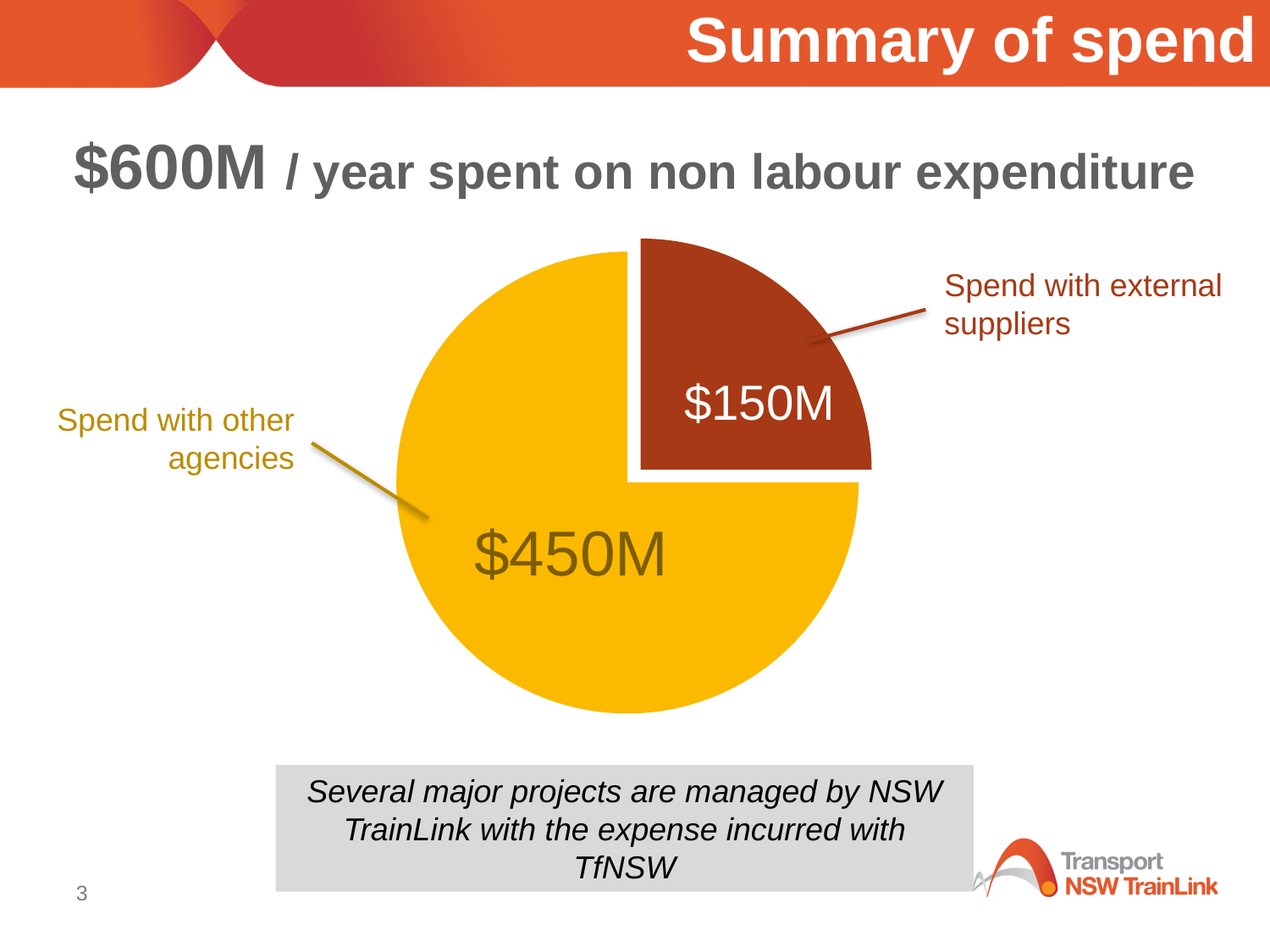
What is the difference between Spend with other agencies and Spend with external suppliers? $300M What colour is the slice for Spend with external suppliers? Dark red What is the value for Spend with external suppliers? $150M How many slices does the pie chart have? 2 Which is larger, Spend with external suppliers or Spend with other agencies? Spend with other agencies What kind of chart is shown on the slide? Pie chart What is the total of the two slices in the pie chart? $600M What share of the pie does Spend with other agencies represent? 75% What is the value for Spend with other agencies? $450M Which category has the largest slice of the pie? Spend with other agencies Which category has the smallest slice of the pie? Spend with external suppliers What share of the pie does Spend with external suppliers represent? 25%